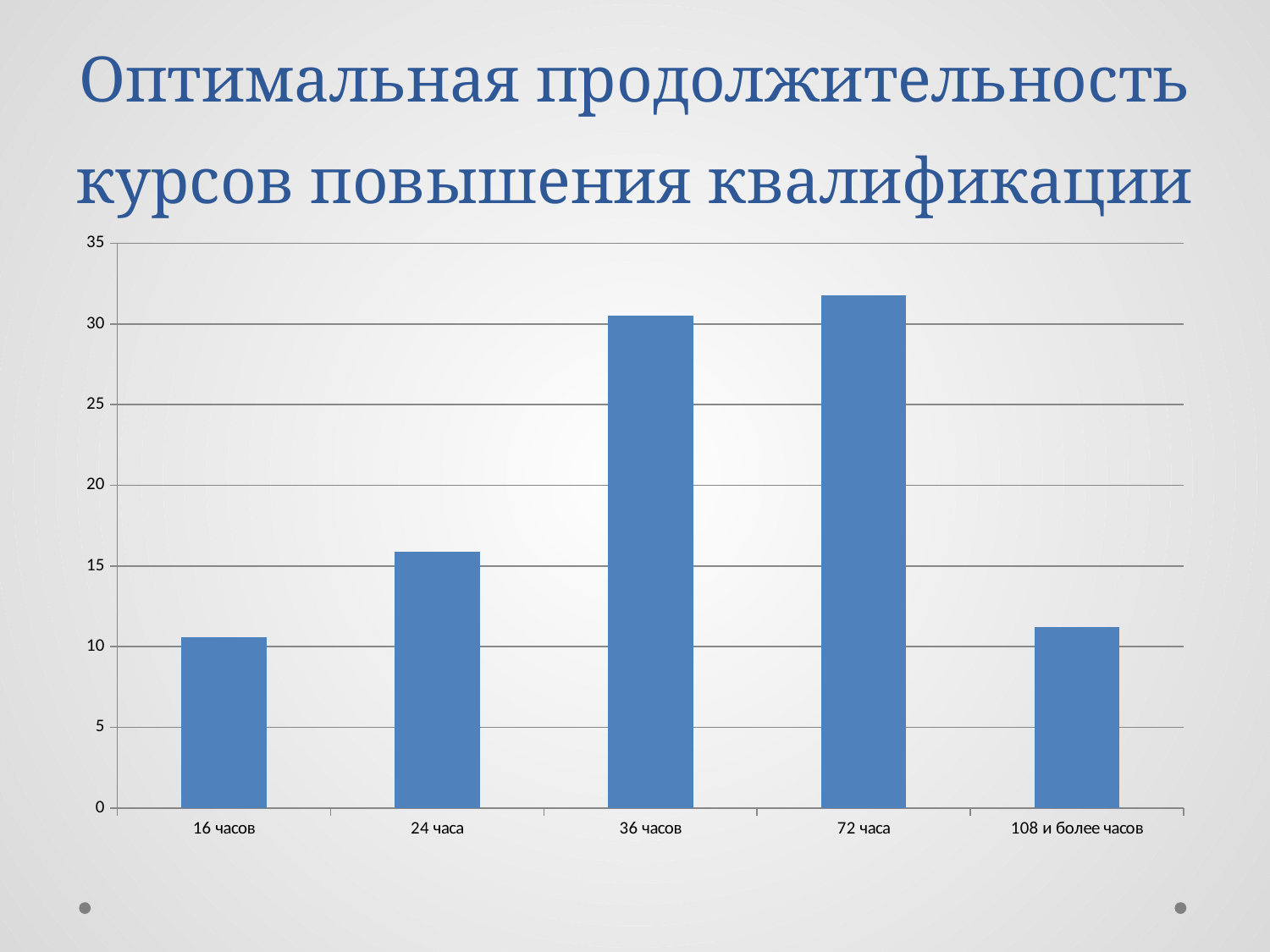
Which is larger, the value for 36 часов or the value for 108 и более часов? 36 часов Is the value for 108 и более часов greater or less than 15? less How many categories are shown on the x axis of the chart? 5 Is the value for 36 часов greater or less than 30? greater Which is larger, the value for 24 часа or the value for 16 часов? 24 часа What is the highest value shown on the vertical axis of the chart? 35 Is the value for 16 часов greater or less than 15? less What is the title of the slide containing the chart? Оптимальная продолжительность курсов повышения квалификации Which category has the highest bar in the chart? 72 часа What kind of chart is shown on the slide? bar chart